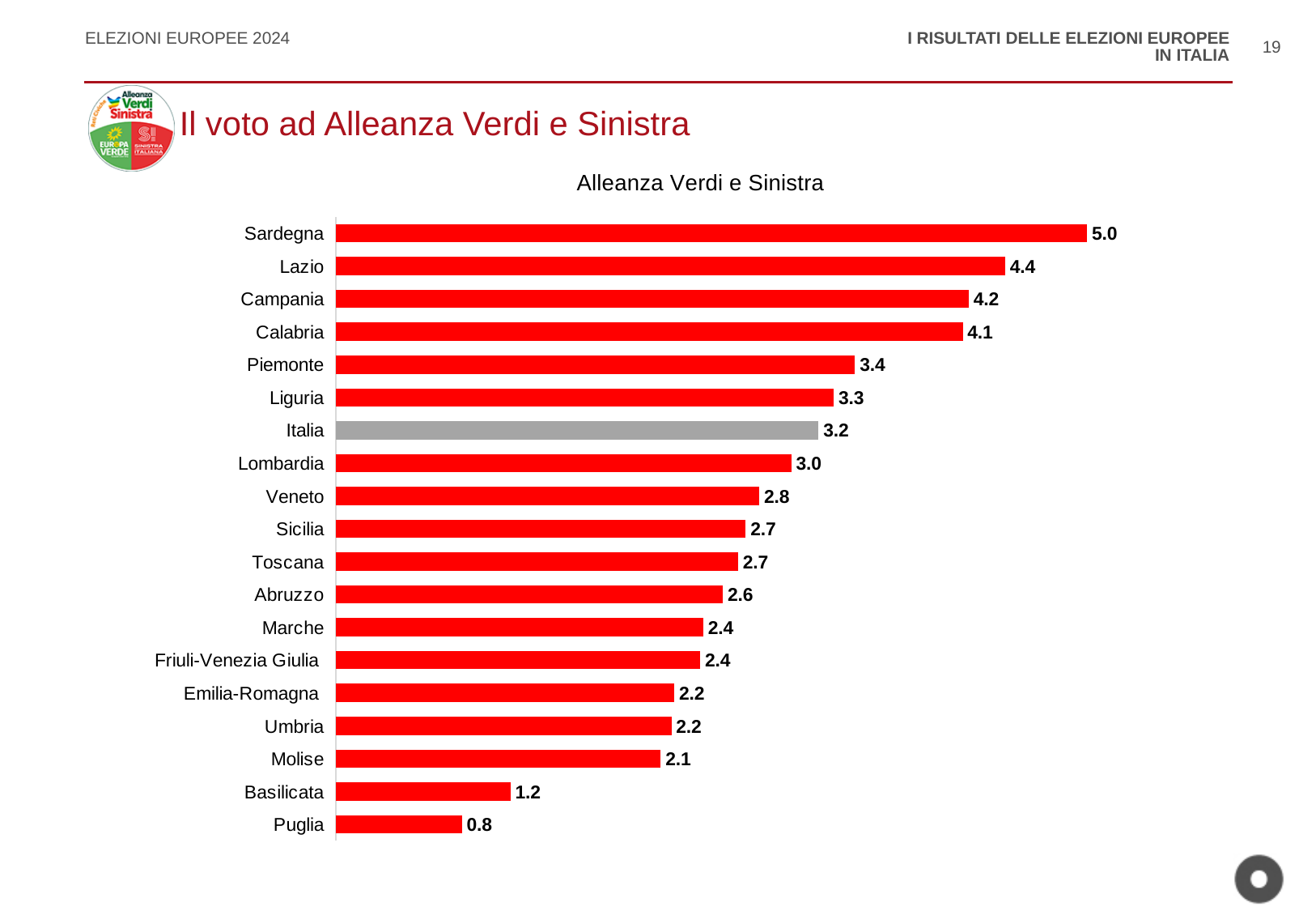
What is the value for Sardegna? 5.0 What kind of chart is shown on the slide? Bar chart How many categories are shown in the chart? 19 Which is larger, the value for Basilicata or the value for Molise? Molise What is the difference between the values for Italia and Puglia? 2.4 What is the difference between the values for Sardegna and Lazio? 0.6 Which category has the lowest value? Puglia Which is larger, the value for Piemonte or the value for Lombardia? Piemonte Which category has the highest value? Sardegna What is the value for Italia? 3.2 What is the value for Puglia? 0.8 What is the title of the chart? Alleanza Verdi e Sinistra